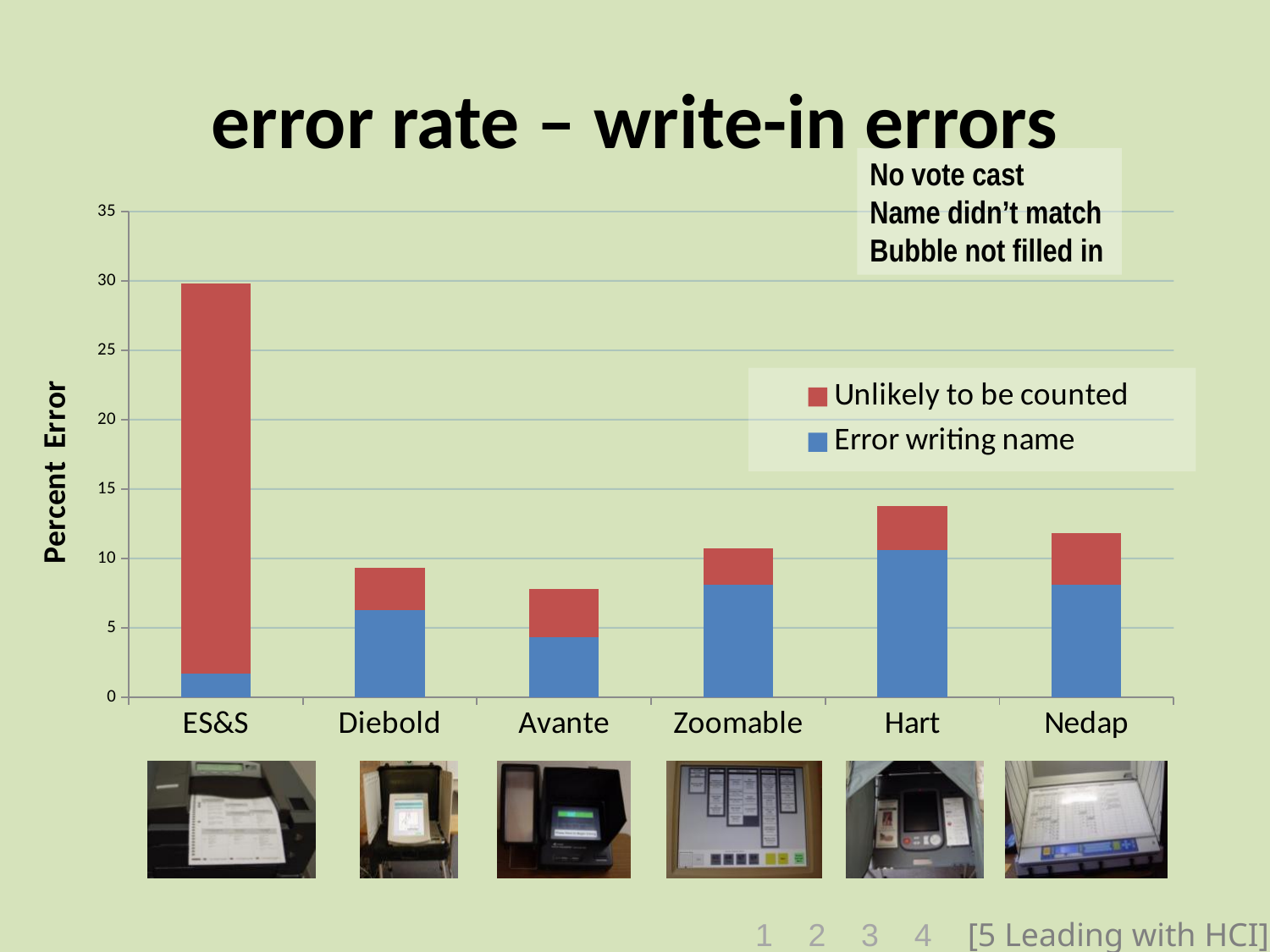
Which voting system has the smallest 'Error writing name' value? ES&S Which has a higher total percent error, Hart or Nedap? Hart Which voting system has the highest total percent error in the chart? ES&S How many voting systems (categories) are shown on the x axis of the chart? 6 Is the total percent error for Hart greater or less than 15? less What is the label on the y axis of the chart? Percent Error Is the total percent error for ES&S greater or less than 25? greater Which voting system has the largest 'Error writing name' value? Hart Which voting system has the lowest total percent error in the chart? Avante What kind of chart is shown on the slide? stacked bar chart How many series does the chart legend list? 2 Is the total percent error for Diebold greater or less than 10? less